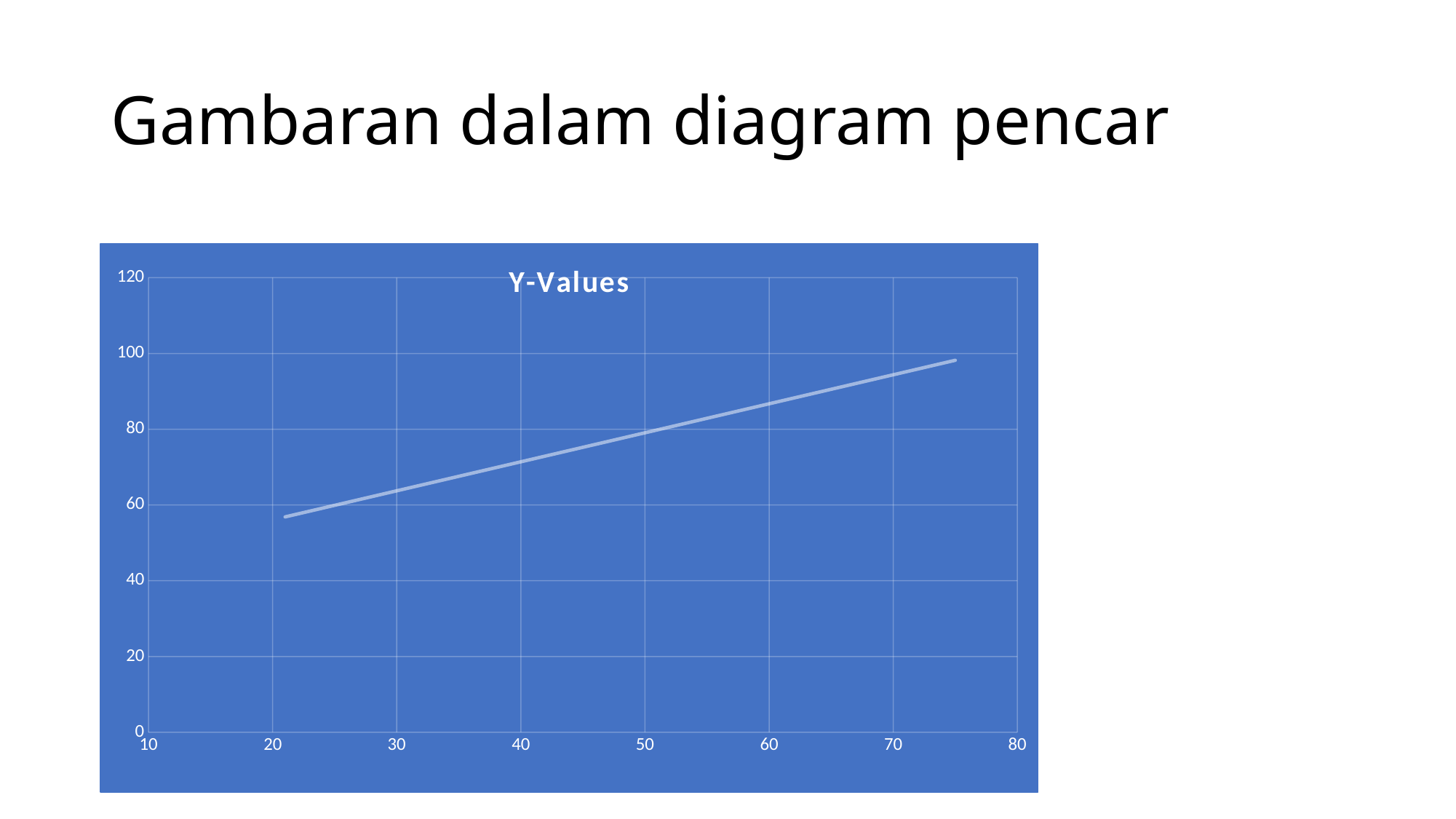
What is the highest value shown on the y axis? 120 Is the value at x = 60 greater or less than 80? greater How many tick labels are shown on the x axis? 8 Is the value at x = 40 greater or less than 80? less Is the value at the right end of the line (near x = 75) greater or less than 100? less What kind of chart is shown on the slide? scatter chart What is the title of the chart? Y-Values Do the values rise or fall as the x axis increases? rise